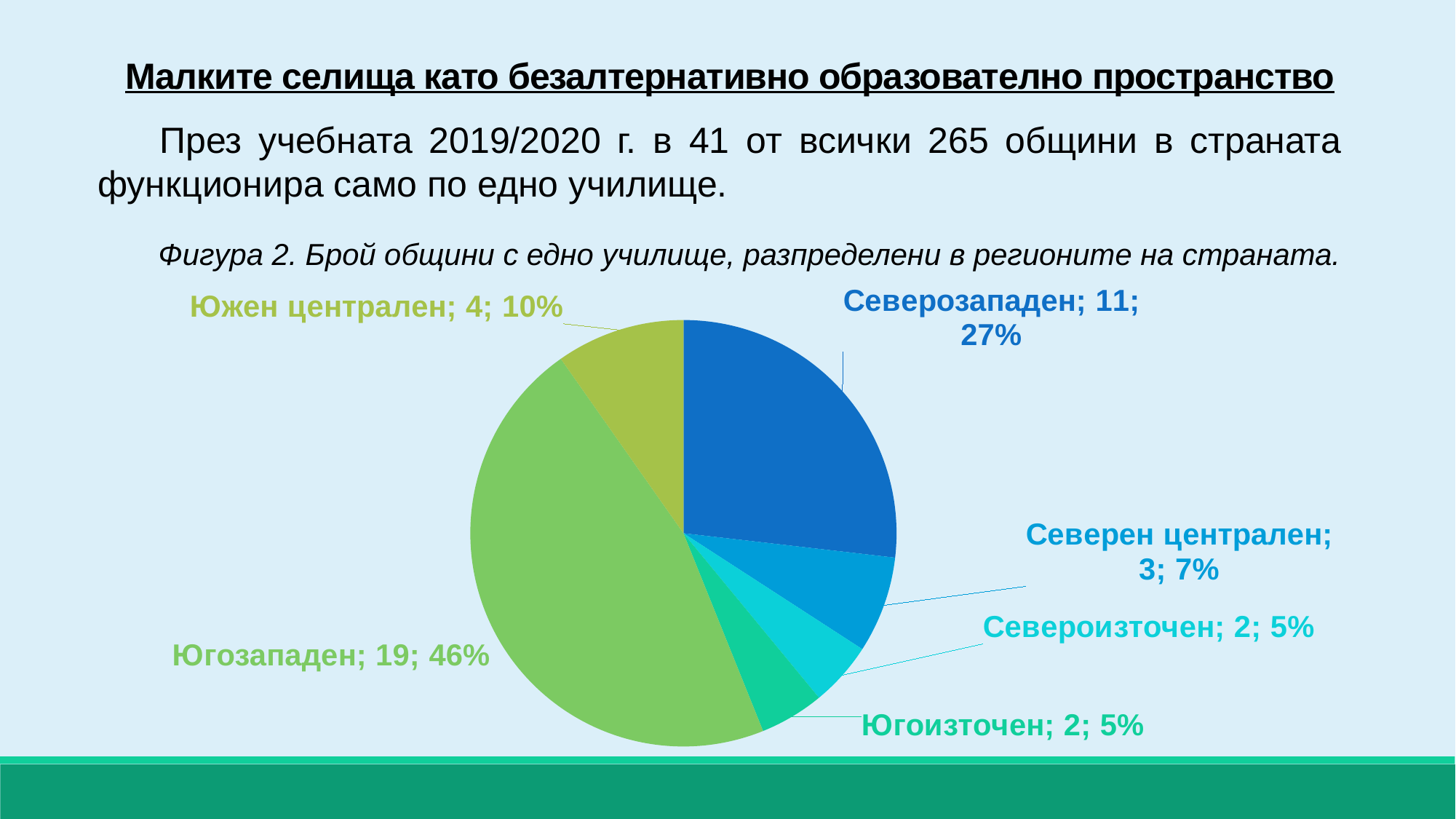
What is the total number of municipalities across all slices of the pie chart? 41 What share of the pie does the Югозападен region hold? 46% Which region has the largest number of municipalities with one school? Югозападен Which region has the largest slice of the pie? Югозападен What share of the pie does the Северен централен region hold? 7% What is the difference between the number of municipalities in Югозападен and Северозападен? 8 What kind of chart is shown on the slide? pie chart How many regions (slices) are shown in the pie chart? 6 How many municipalities with one school are in the Южен централен region? 4 What is the caption (title) of the figure shown on the slide? Фигура 2. Брой общини с едно училище, разпределени в регионите на страната. Which has more municipalities with one school, Северозападен or Южен централен? Северозападен How many municipalities with one school are in the Северозападен region? 11